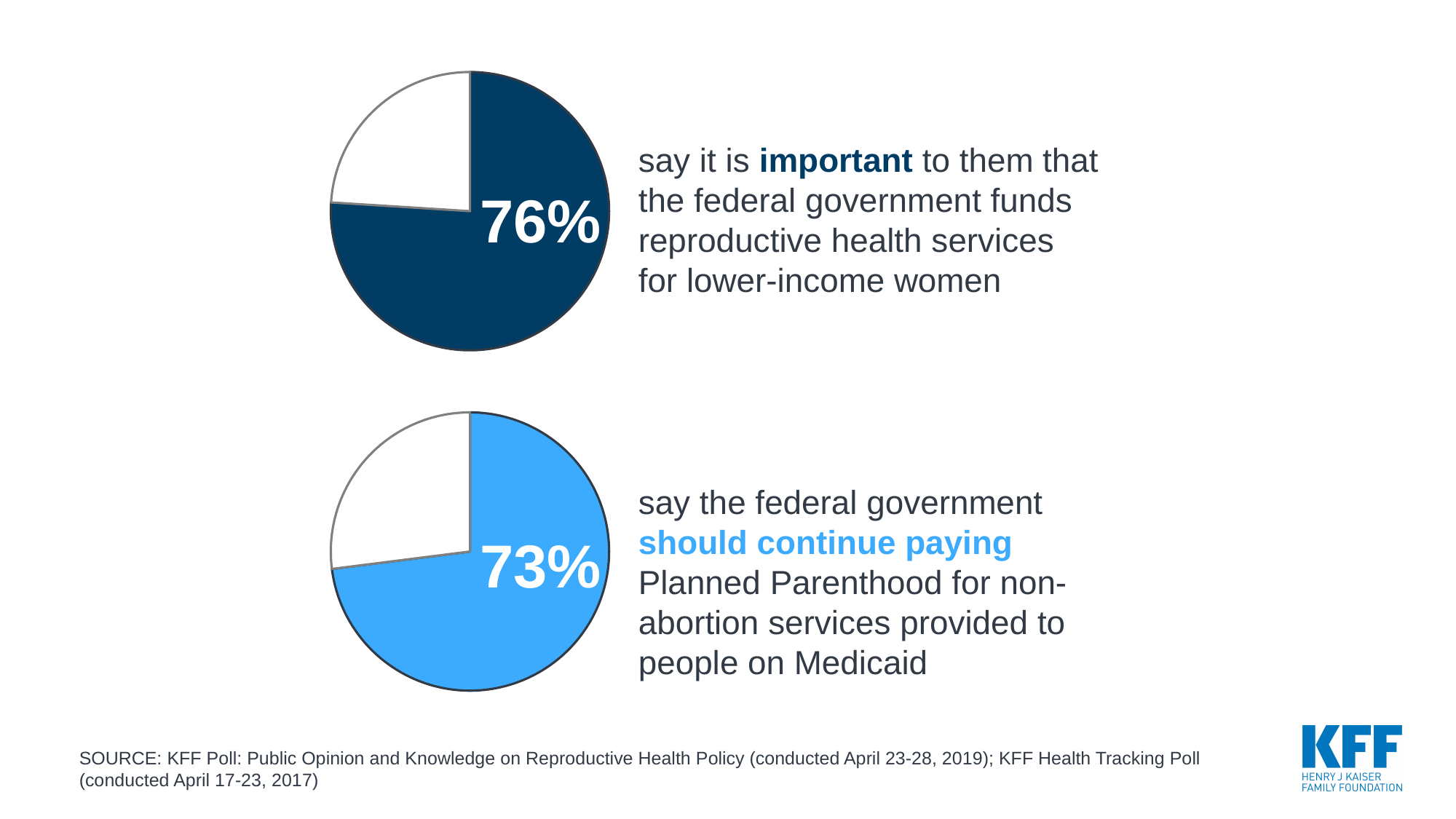
What colour is the filled slice in the bottom pie chart? Light blue How many pie charts are shown on the slide? 2 Which is larger: the share who say it is important that the federal government funds reproductive health services for lower-income women, or the share who say the federal government should continue paying Planned Parenthood for non-abortion services? The share who say it is important that the federal government funds reproductive health services (76%) In the top pie chart, what percentage say it is important to them that the federal government funds reproductive health services for lower-income women? 76% What colour is the filled slice in the top pie chart? Dark navy blue Is the value shown in the top pie chart greater or less than 50%? greater In the bottom pie chart, what percentage say the federal government should continue paying Planned Parenthood for non-abortion services provided to people on Medicaid? 73% What kind of chart is used on this slide to show the 76% and 73% figures? Pie chart In the bottom pie chart, what share of the pie is not filled in (the white portion)? 27% What is the difference in percentage points between the 76% in the top pie chart and the 73% in the bottom pie chart? 3 percentage points In the top pie chart, what share of the pie is not filled in (the white portion)? 24%